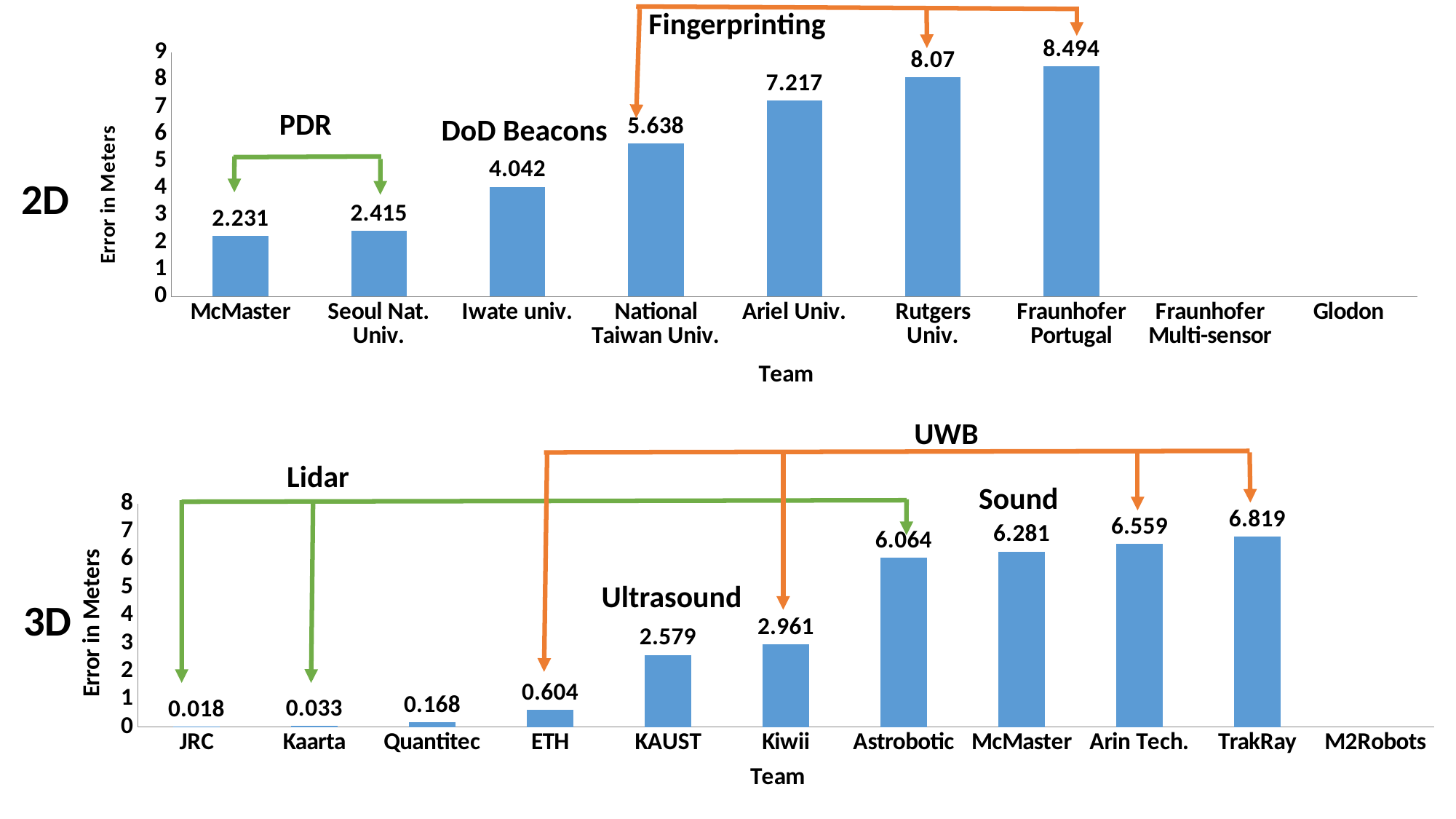
In the 3D chart, which team has the lowest error? JRC In the 2D chart, what is the difference in error between Fraunhofer Portugal and McMaster? 6.263 In the 2D chart, which team has the lowest plotted error? McMaster In the 2D chart, which has a larger error, Ariel Univ. or National Taiwan Univ.? Ariel Univ. In the 3D chart, which team has the highest error? TrakRay In the 2D chart, which team has the highest error? Fraunhofer Portugal In the 2D chart, how many teams are listed on the x axis? 9 In the 3D chart, what is the difference in error between Kiwii and KAUST? 0.382 In the 3D chart, what is the error in meters for Kiwii? 2.961 In the 2D chart, what is the error in meters for Iwate univ.? 4.042 In the 3D chart, do the plotted error values rise or fall from left to right along the x axis? rise What type of chart is the 3D chart? bar chart